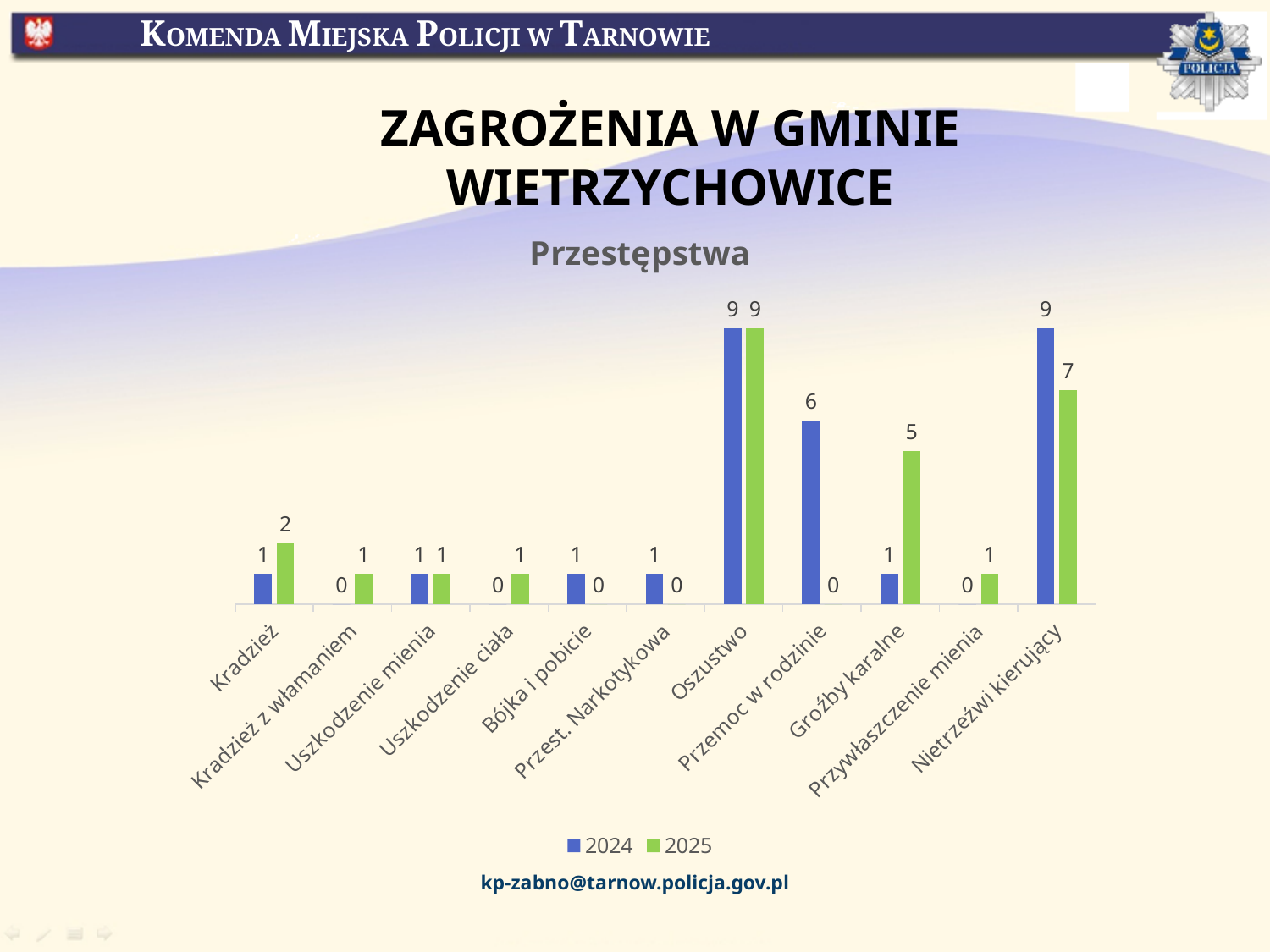
What is the value for Groźby karalne in 2025? 5 Which is larger for Groźby karalne, the 2024 value or the 2025 value? 2025 What type of chart is shown on the slide? bar chart What is the value for Nietrzeźwi kierujący in 2025? 7 What is the difference between the 2024 and 2025 values for Przemoc w rodzinie? 6 What is the title of the chart? Przestępstwa Which category has the highest value for 2025? Oszustwo How many categories are shown on the x axis? 11 What is the value for Oszustwo in 2025? 9 What is the difference between the 2024 and 2025 values for Nietrzeźwi kierujący? 2 What is the value for Przemoc w rodzinie in 2024? 6 How many series does the legend list? 2